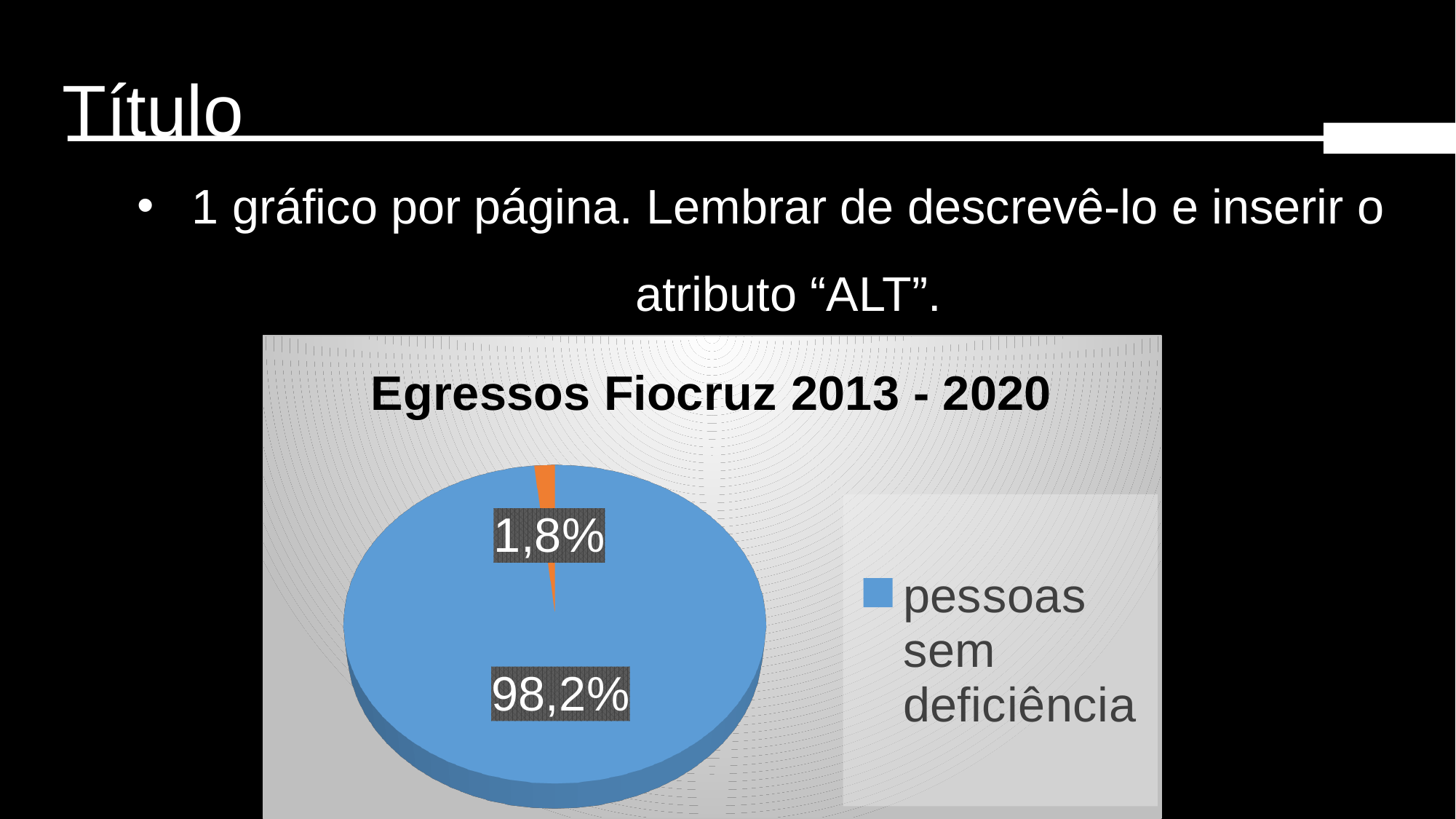
What is the value shown on the smaller slice of the pie? 1,8% What share of the pie is labelled "pessoas sem deficiência"? 98,2% What is the smallest value shown on the pie chart? 1,8% How many slices does the pie chart have? 2 What colour is the slice for "pessoas sem deficiência"? blue What is the title of the chart? Egressos Fiocruz 2013 - 2020 What kind of chart is shown on the slide? pie chart Is the slice for "pessoas sem deficiência" larger or smaller than the other slice? larger What is the largest value shown on the pie chart? 98,2% Which category has the largest slice of the pie? pessoas sem deficiência What is the difference in percentage points between the two slices of the pie? 96,4